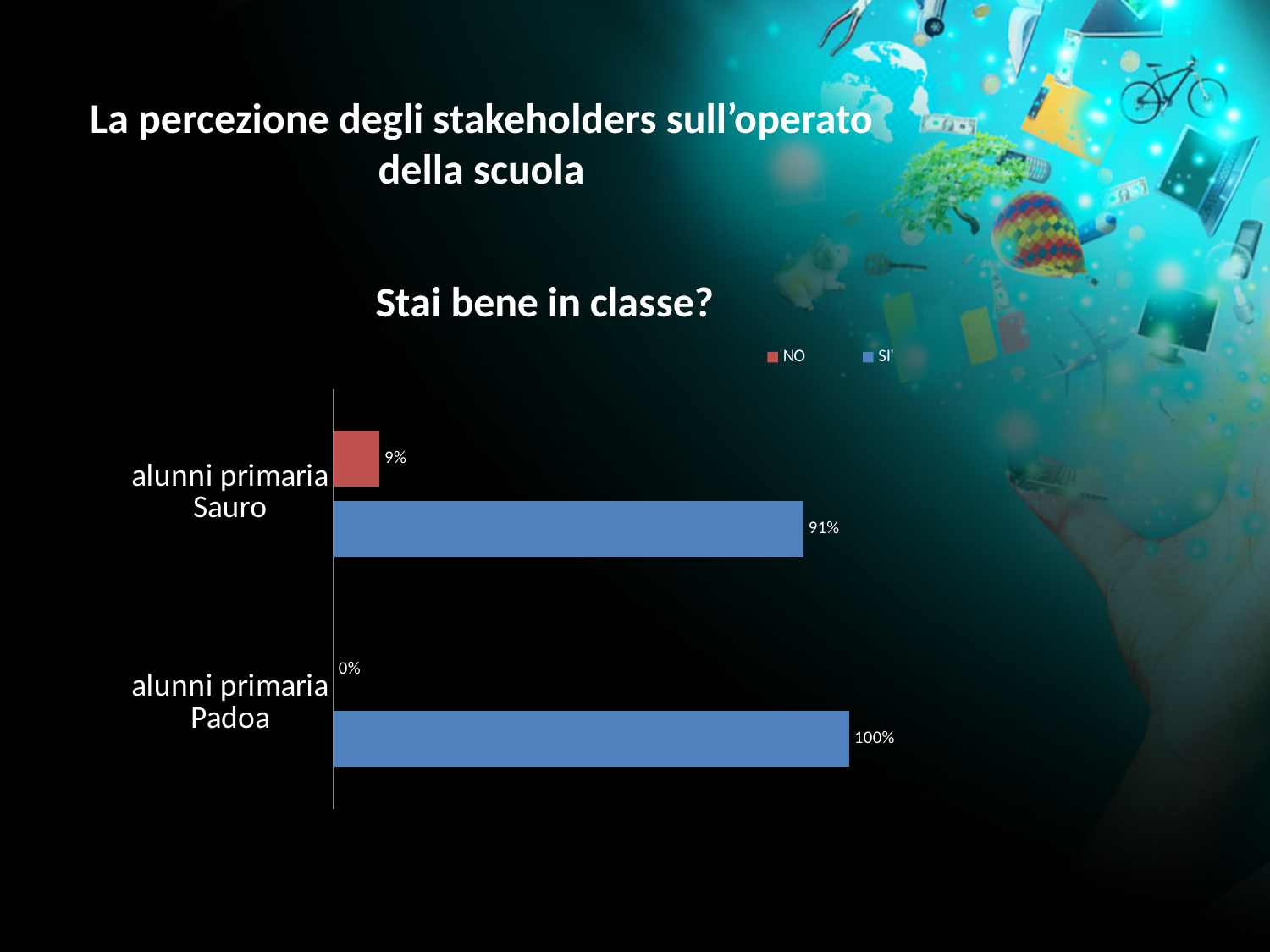
What is the NO value for alunni primaria Padoa? 0% Which category has the higher SI' value? alunni primaria Padoa What is the difference between the SI' values for alunni primaria Padoa and alunni primaria Sauro? 9% What is the SI' value for alunni primaria Sauro? 91% Is the NO value for alunni primaria Sauro larger or smaller than its SI' value? smaller What is the difference between the SI' and NO values for alunni primaria Sauro? 82% What is the NO value for alunni primaria Sauro? 9% How many series does the legend list? 2 How many categories are shown on the chart? 2 What is the SI' value for alunni primaria Padoa? 100% Which category has the lower NO value? alunni primaria Padoa What kind of chart is shown on the slide? bar chart